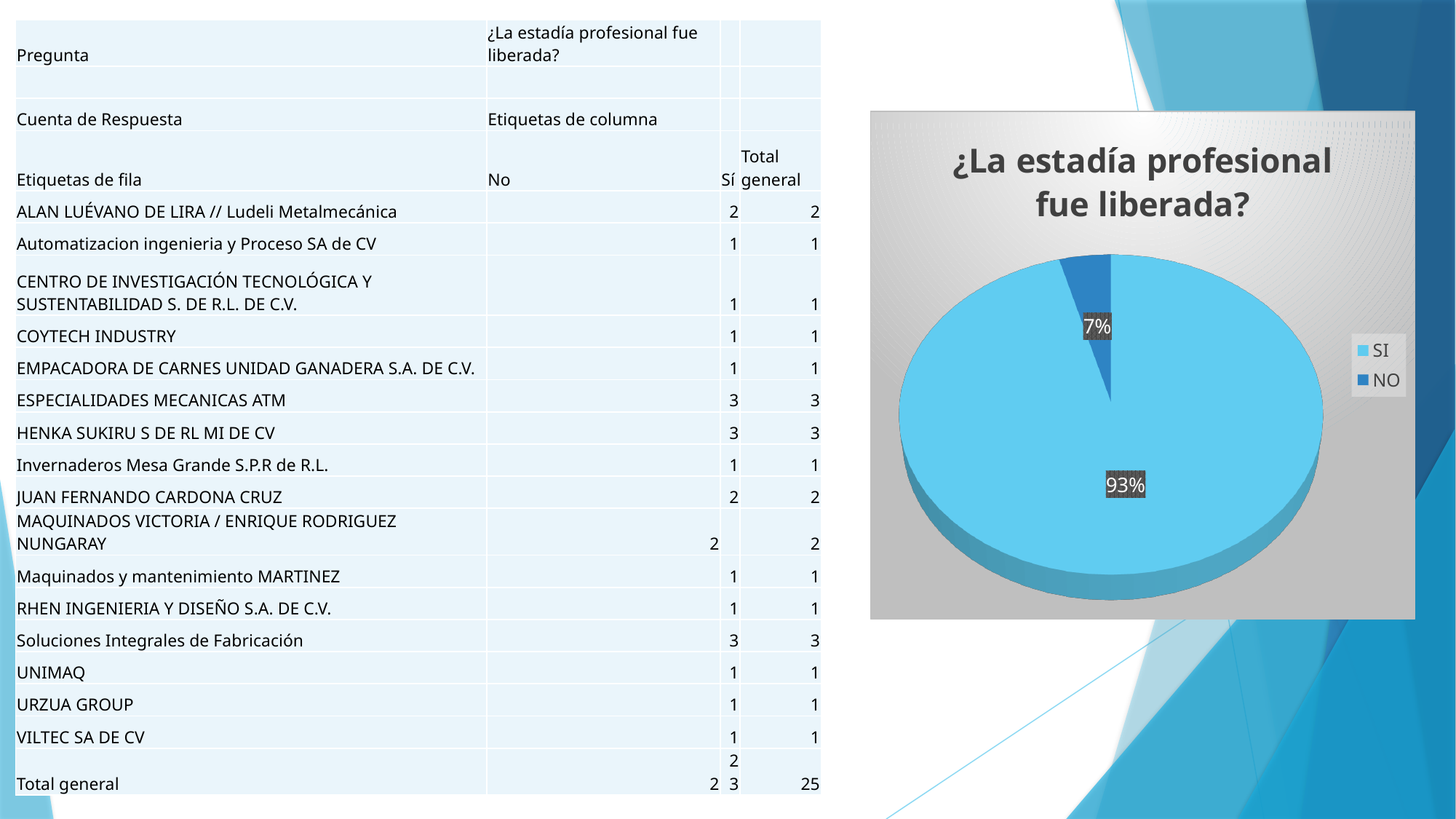
What percentage of the pie chart is labelled NO? 7% Which slice is larger in the pie chart, SI or NO? SI Which slice of the pie chart is the smallest? NO What is the difference in percentage points between the SI and NO slices of the pie chart? 86 What is the title of the pie chart? ¿La estadía profesional fue liberada? What are the two legend entries of the pie chart? SI and NO Which slice of the pie chart is the largest? SI What kind of chart is shown on the slide? pie chart What percentage of the pie chart is labelled SI? 93% How many slices does the pie chart have? 2 How many entries does the legend of the pie chart list? 2